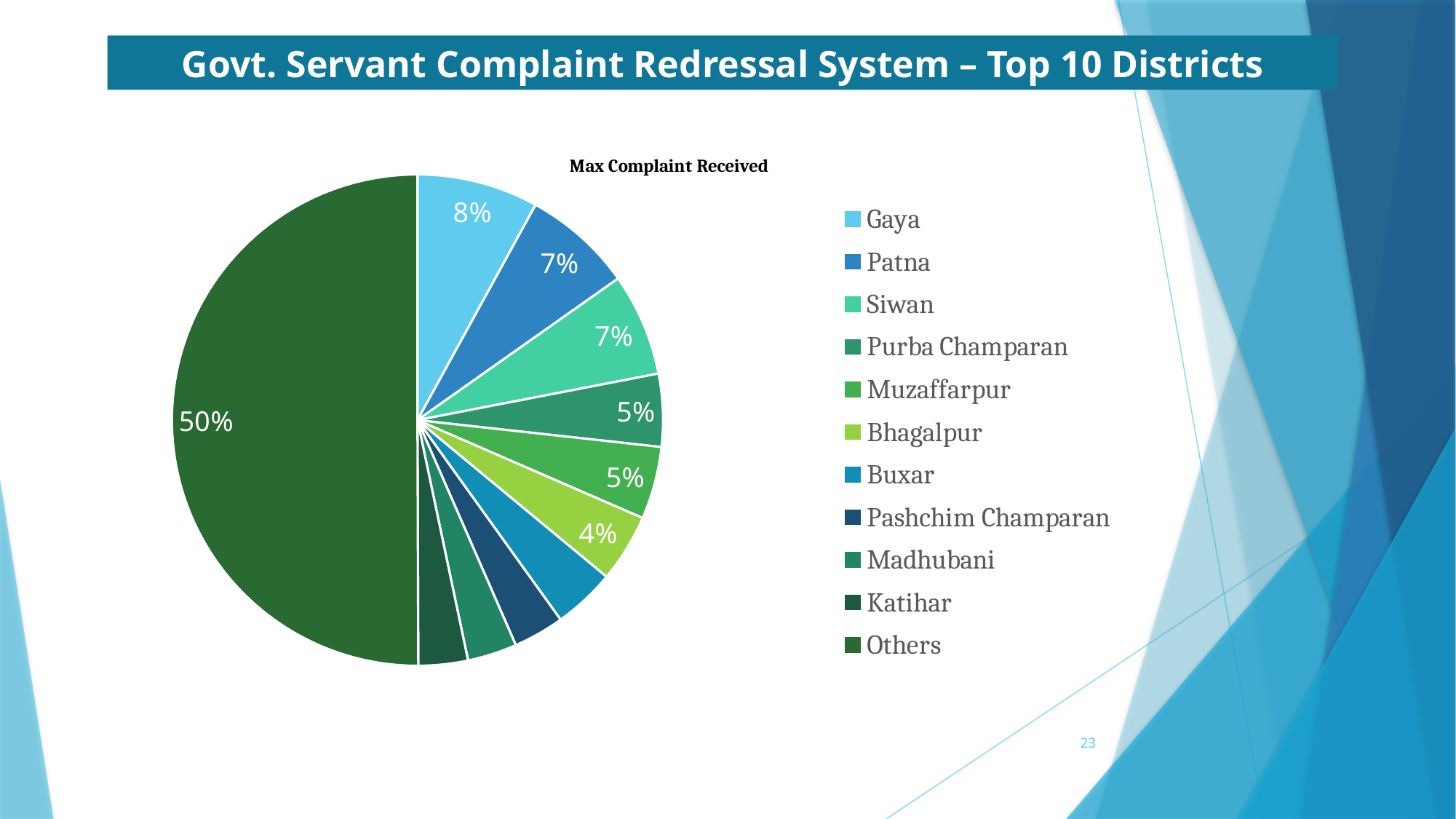
What percentage of the pie does Gaya account for? 8% How many categories are listed in the legend of the pie chart? 11 What type of chart is shown on the slide? Pie chart Which has a larger share, Gaya or Patna? Gaya What is the title of the chart? Max Complaint Received What is the difference in percentage points between Gaya and Bhagalpur? 4% What percentage is shown for Bhagalpur? 4% Which has a larger share, Muzaffarpur or Bhagalpur? Muzaffarpur Which category has the largest slice of the pie? Others What percentage is shown for Purba Champaran? 5% What percentage is shown for Others in the pie chart? 50% What is the difference in percentage points between Others and Gaya? 42%